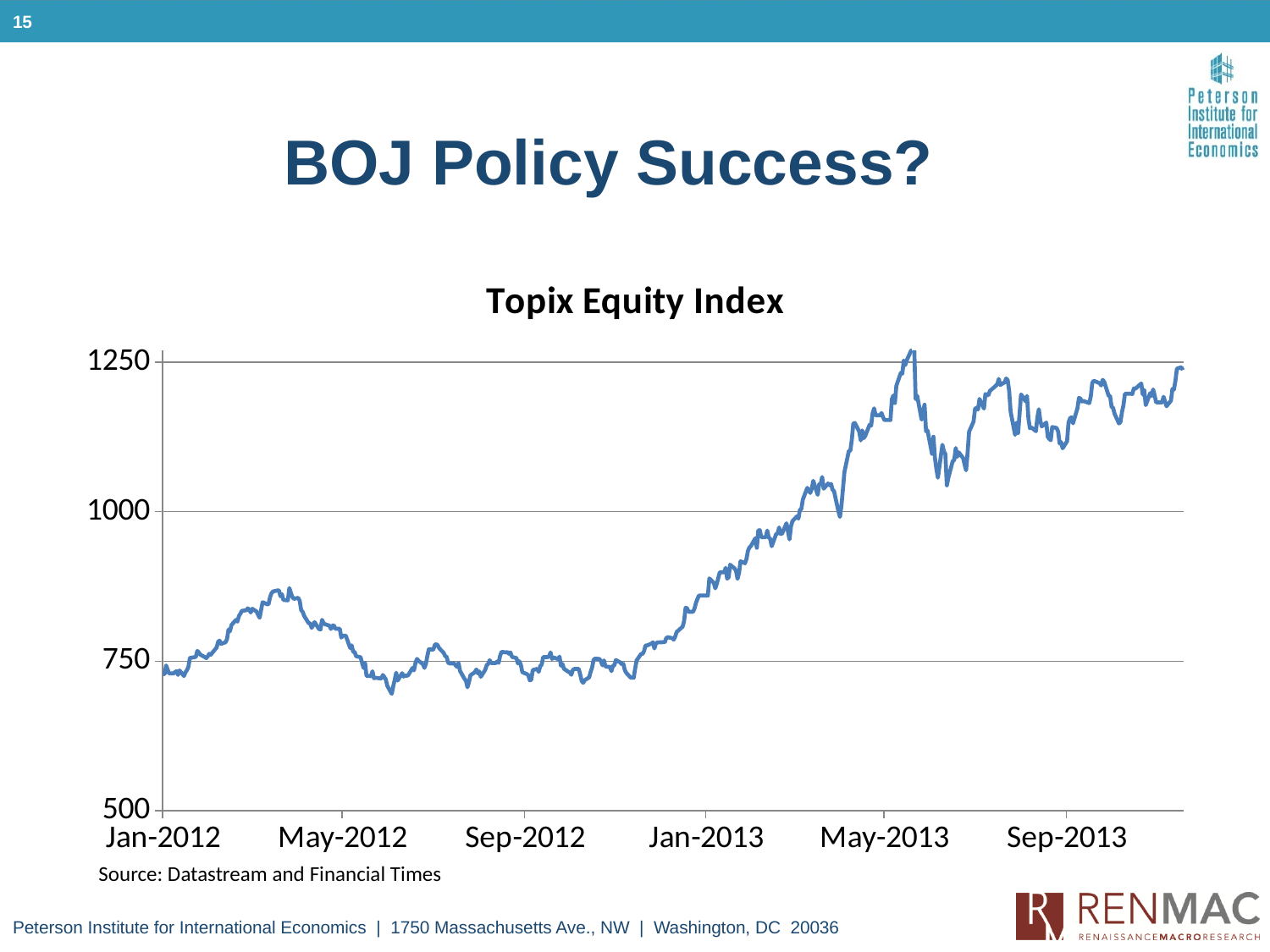
Is the value of the Topix Equity Index at Sep-2013 greater or less than 1000? greater Is the value of the Topix Equity Index at May-2013 greater or less than 1000? greater Is the value of the Topix Equity Index at Sep-2012 greater or less than 1000? less How many data series (lines) are plotted on the chart? 1 What is the highest value shown on the y axis of the chart? 1250 Is the Topix Equity Index higher at Sep-2013 or at Sep-2012? Sep-2013 Overall, does the Topix Equity Index rise or fall from the start of the chart to the end? rise What kind of chart is shown on the slide? line chart Does the Topix Equity Index rise or fall between Jan-2013 and May-2013? rise What is the title of the chart? Topix Equity Index How many date labels are shown on the x axis of the chart? 6